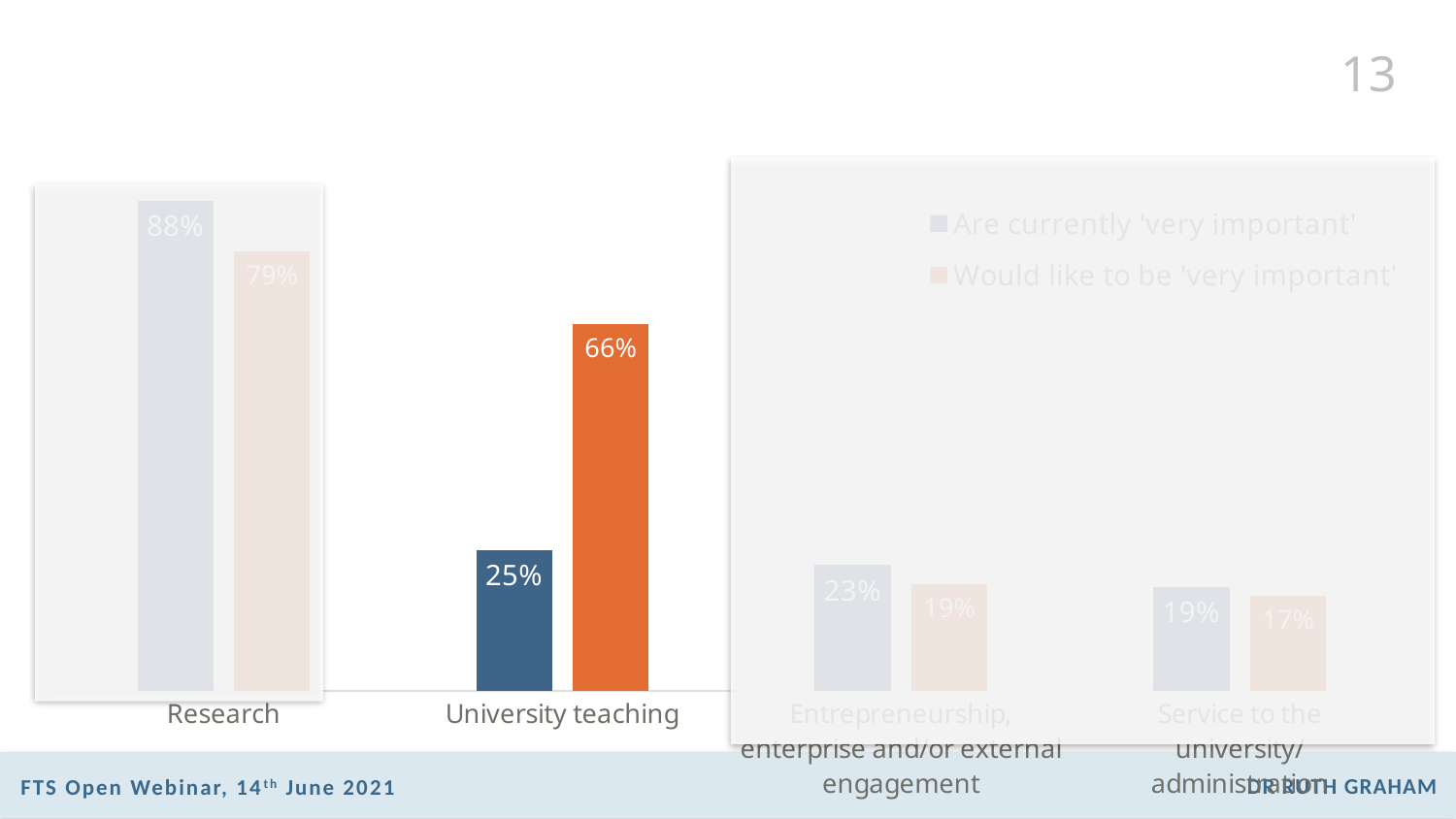
For Research, which is larger: the 'Are currently ‘very important’' value or the 'Would like to be ‘very important’' value? Are currently 'very important' What is the value for 'Are currently ‘very important’' for University teaching? 25% What is the value for 'Would like to be ‘very important’' for University teaching? 66% How many series does the legend list? 2 What is the value for 'Would like to be ‘very important’' for Research? 79% How many categories are shown on the x axis? 4 What kind of chart is shown on the slide? Bar chart What is the difference between the 'Would like to be' and 'Are currently' values for University teaching? 41% What is the value for 'Are currently ‘very important’' for Entrepreneurship, enterprise and/or external engagement? 23% What is the value for 'Are currently ‘very important’' for Research? 88% Which category has the lowest value for 'Would like to be ‘very important’'? Service to the university/administration Which category has the highest value for 'Are currently ‘very important’'? Research